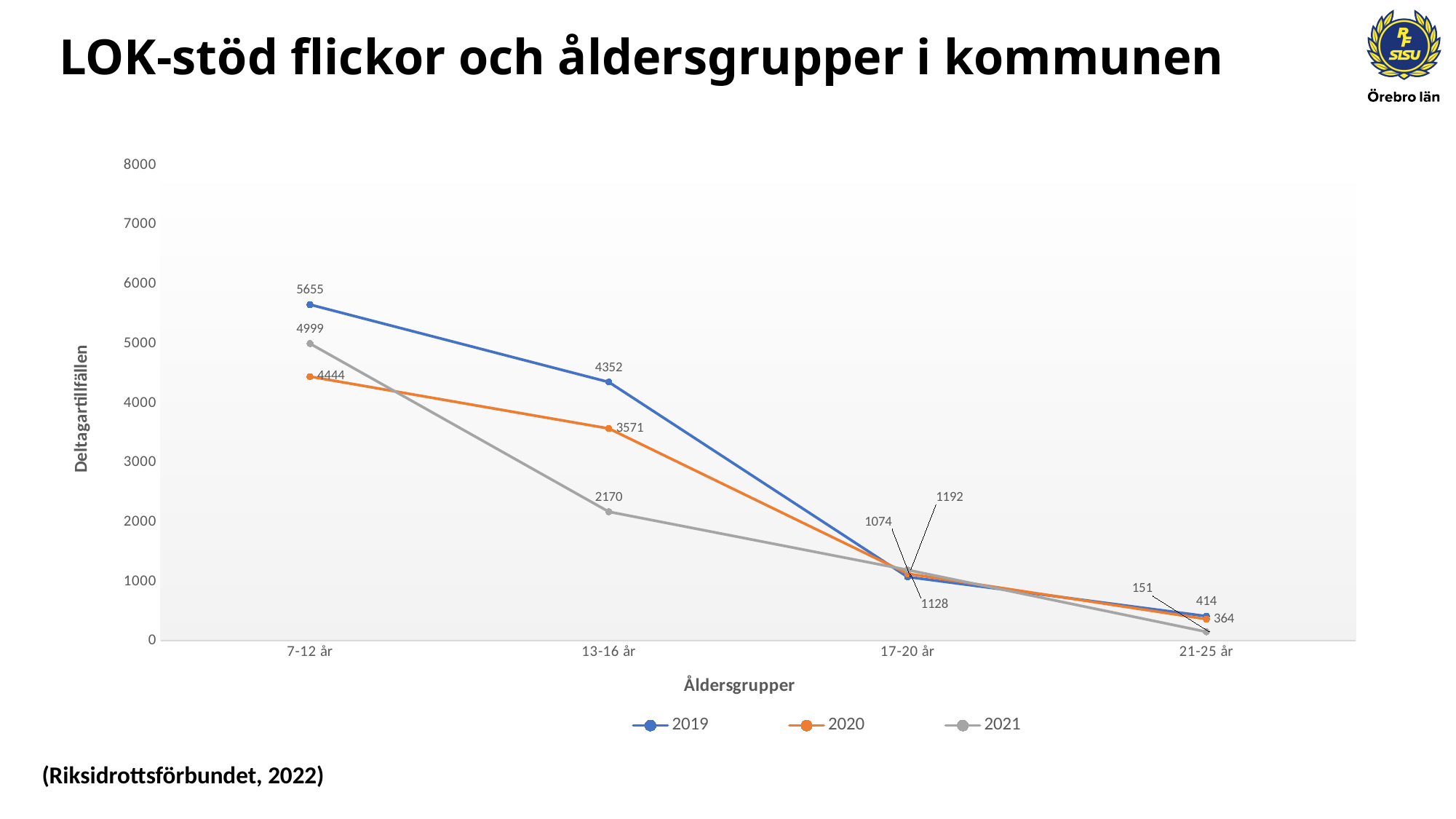
What is the value for 2020 in the 7-12 år age group? 4444 What is the value for 2020 in the 13-16 år age group? 3571 How many series does the legend list? 3 In the 7-12 år age group, which series has the larger value, 2020 or 2021? 2021 Do the values for the 2019 series rise or fall from 7-12 år to 21-25 år? fall What is the value for 2021 in the 21-25 år age group? 151 What kind of chart is shown on the slide? line chart What is the title of the y axis? Deltagartillfällen What is the difference between the 2019 and 2020 values in the 7-12 år age group? 1211 How many age groups are shown on the x axis? 4 What is the value for 2019 in the 7-12 år age group? 5655 Which age group has the highest value for the 2019 series? 7-12 år